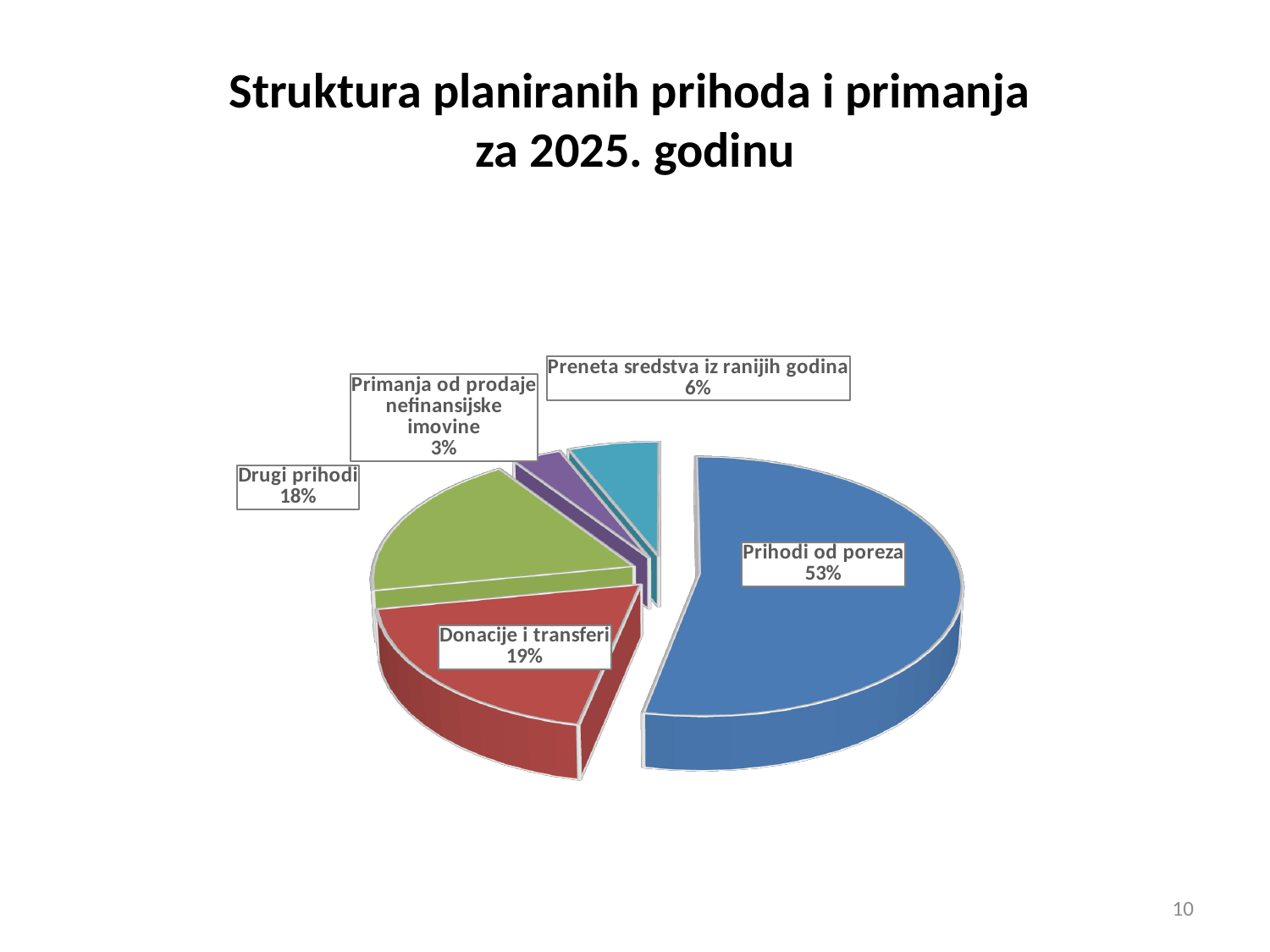
Which category has the smallest slice of the pie? Primanja od prodaje nefinansijske imovine How many slices does the pie chart have? 5 What share of the pie does "Primanja od prodaje nefinansijske imovine" represent? 3% What is the difference in percentage points between "Prihodi od poreza" and "Donacije i transferi"? 34 What share of the pie does "Drugi prihodi" represent? 18% Which category has the largest slice of the pie? Prihodi od poreza What is the title of the slide containing the chart? Struktura planiranih prihoda i primanja za 2025. godinu What share of the pie does "Donacije i transferi" represent? 19% What kind of chart is shown on the slide? Pie chart Which is larger, "Preneta sredstva iz ranijih godina" or "Primanja od prodaje nefinansijske imovine"? Preneta sredstva iz ranijih godina